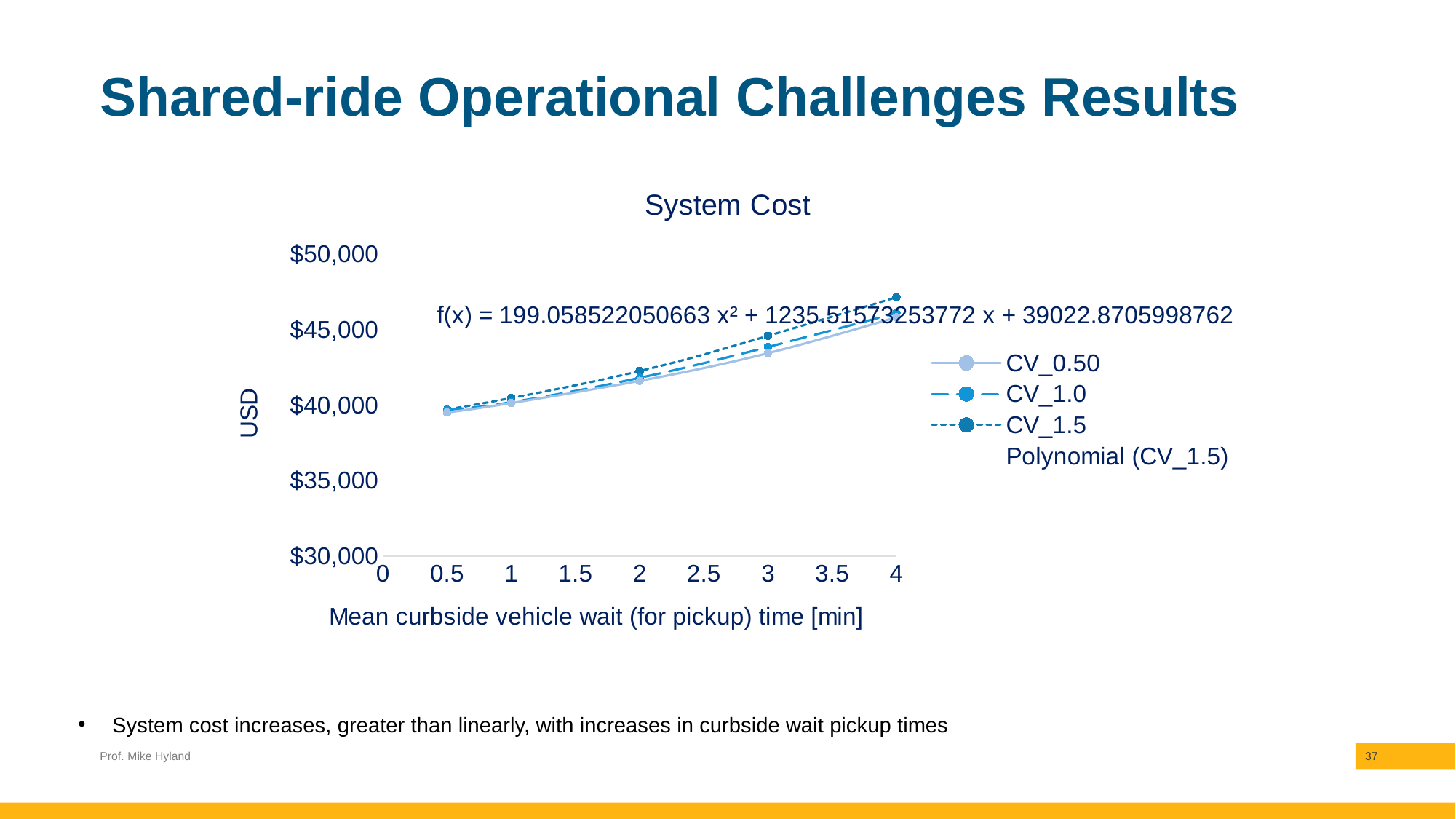
How many entries does the chart legend list? 4 What kind of chart is shown on the slide? line chart How many data points are plotted for the CV_1.5 series? 5 What is the title of the chart? System Cost At which mean curbside wait time does the CV_1.5 series reach its highest system cost? 4 At a wait time of 4 minutes, which series has the higher system cost, CV_1.5 or CV_0.50? CV_1.5 What is the label of the x axis? Mean curbside vehicle wait (for pickup) time [min] At which mean curbside wait time does the CV_0.50 series have its lowest system cost? 0.5 Is the CV_1.5 value at a wait time of 4 minutes greater or less than $45,000? greater Do the system cost values rise or fall as mean curbside vehicle wait time increases? rise Is the CV_0.50 value at a wait time of 2 minutes greater or less than $45,000? less Is the CV_1.0 value at a wait time of 2 minutes greater or less than $40,000? greater